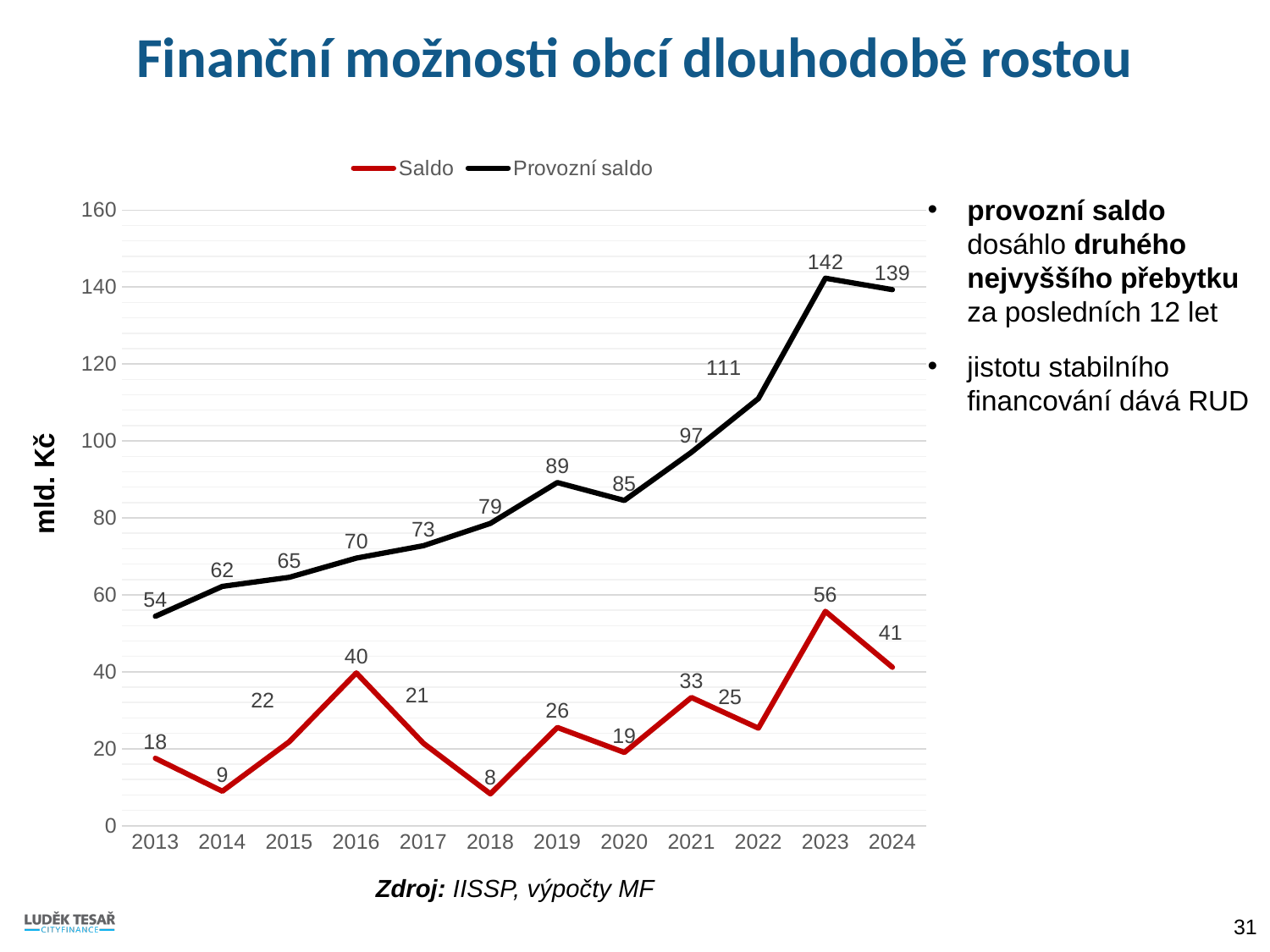
How many years are shown on the x axis? 12 Which is larger, Saldo in 2016 or Saldo in 2021? Saldo in 2016 What kind of chart is shown on the slide? line chart What is the value of Saldo in 2018? 8 In which year is Provozní saldo lowest? 2013 How many series does the legend list? 2 Is the value of Provozní saldo in 2022 greater or less than 100? greater What is the difference between Provozní saldo and Saldo in 2024? 98 Does Provozní saldo generally rise or fall from 2013 to 2023? rise What unit is shown on the y axis label? mld. Kč What is the value of Provozní saldo in 2023? 142 In which year is Saldo highest? 2023